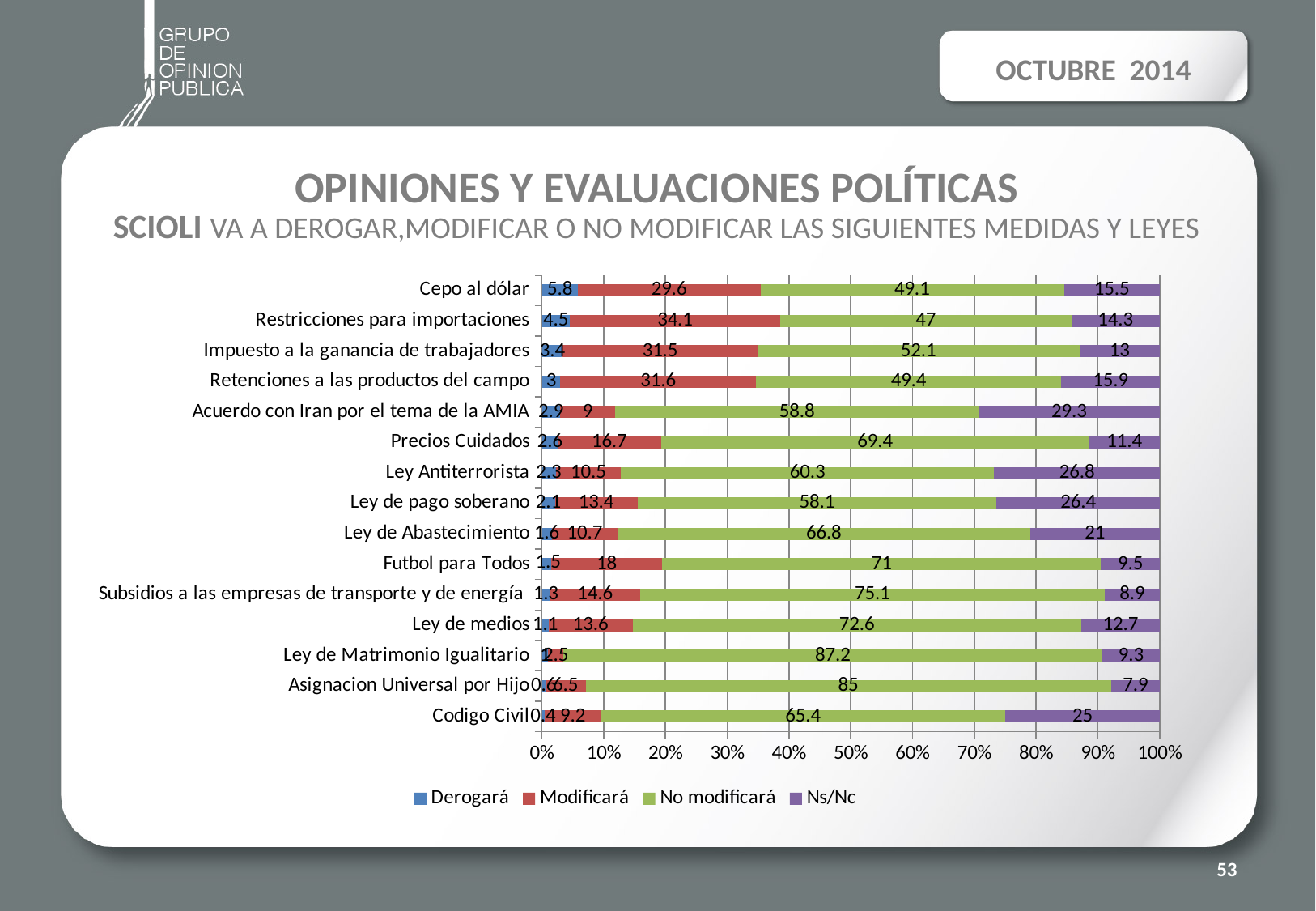
Which category has the highest 'No modificará' value? Ley de Matrimonio Igualitario What is the 'No modificará' value for Ley de Matrimonio Igualitario? 87.2 What is the difference between the 'No modificará' values for Futbol para Todos and Precios Cuidados? 1.6 How many series does the legend list? 4 What type of chart is shown on the slide? Stacked bar chart Which is larger: the 'Ns/Nc' value for Codigo Civil or for Ley de Abastecimiento? Codigo Civil How many categories (measures and laws) are plotted on the chart? 15 Which category has the highest 'Derogará' value? Cepo al dólar Which series is shown in green in the legend? No modificará What is the 'Derogará' value for Cepo al dólar? 5.8 What is the 'Modificará' value for Restricciones para importaciones? 34.1 What is the 'Ns/Nc' value for Acuerdo con Iran por el tema de la AMIA? 29.3